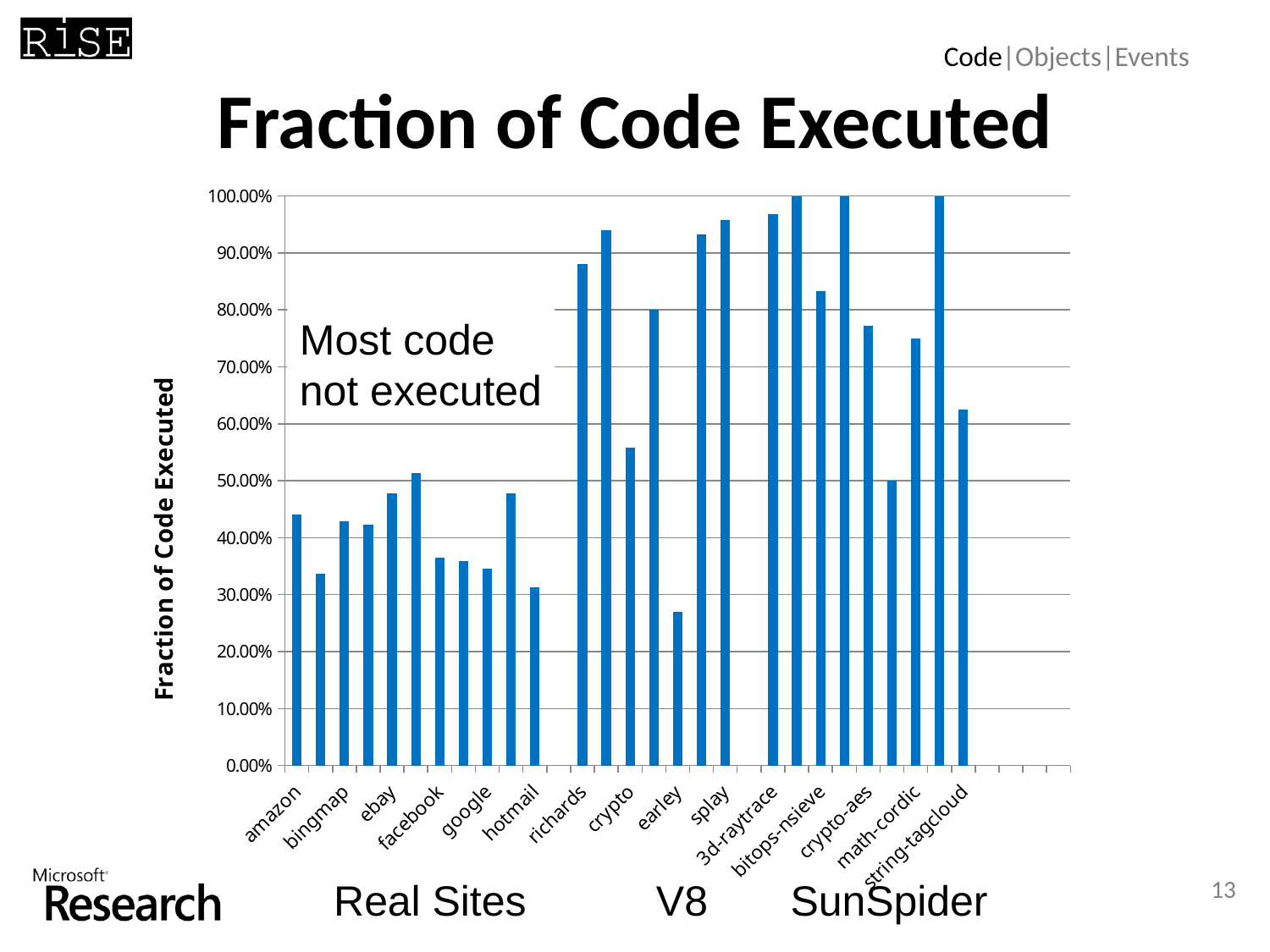
What kind of chart is shown on the slide? bar chart Is the value for amazon greater or less than 40.00%? greater Is the value for string-tagcloud greater or less than 60.00%? greater What is the label on the vertical axis of the chart? Fraction of Code Executed Is the value for earley greater or less than 30.00%? less Which has a higher fraction of code executed, richards or amazon? richards What is the title of the chart? Fraction of Code Executed Which labeled category has the lowest fraction of code executed? earley